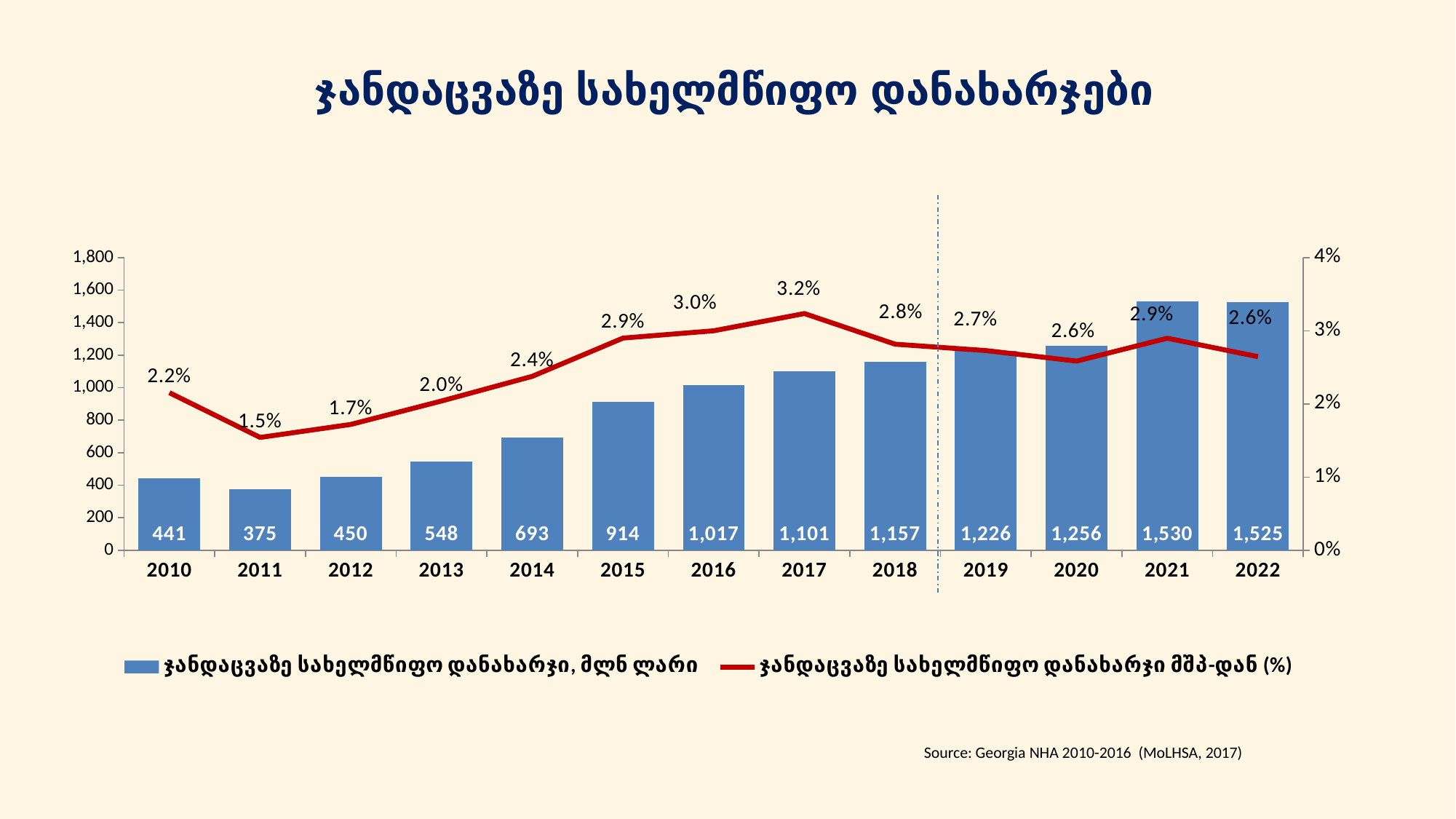
Do the bar values generally rise or fall from 2011 to 2021? Rise What percentage does the line series show for 2017? 3.2% Which year has the lowest bar value? 2011 What is the value of the bar for 2015? 914 In which year does the line series reach its lowest percentage? 2011 What is the value of the bar for 2022? 1,525 What is the difference between the bar values for 2021 and 2020? 274 What kind of chart is shown on the slide? Combined bar and line chart How many series does the legend list? 2 Which is larger, the bar value for 2013 or for 2014? 2014 Which year has the highest bar value? 2021 How many years are shown on the x axis? 13